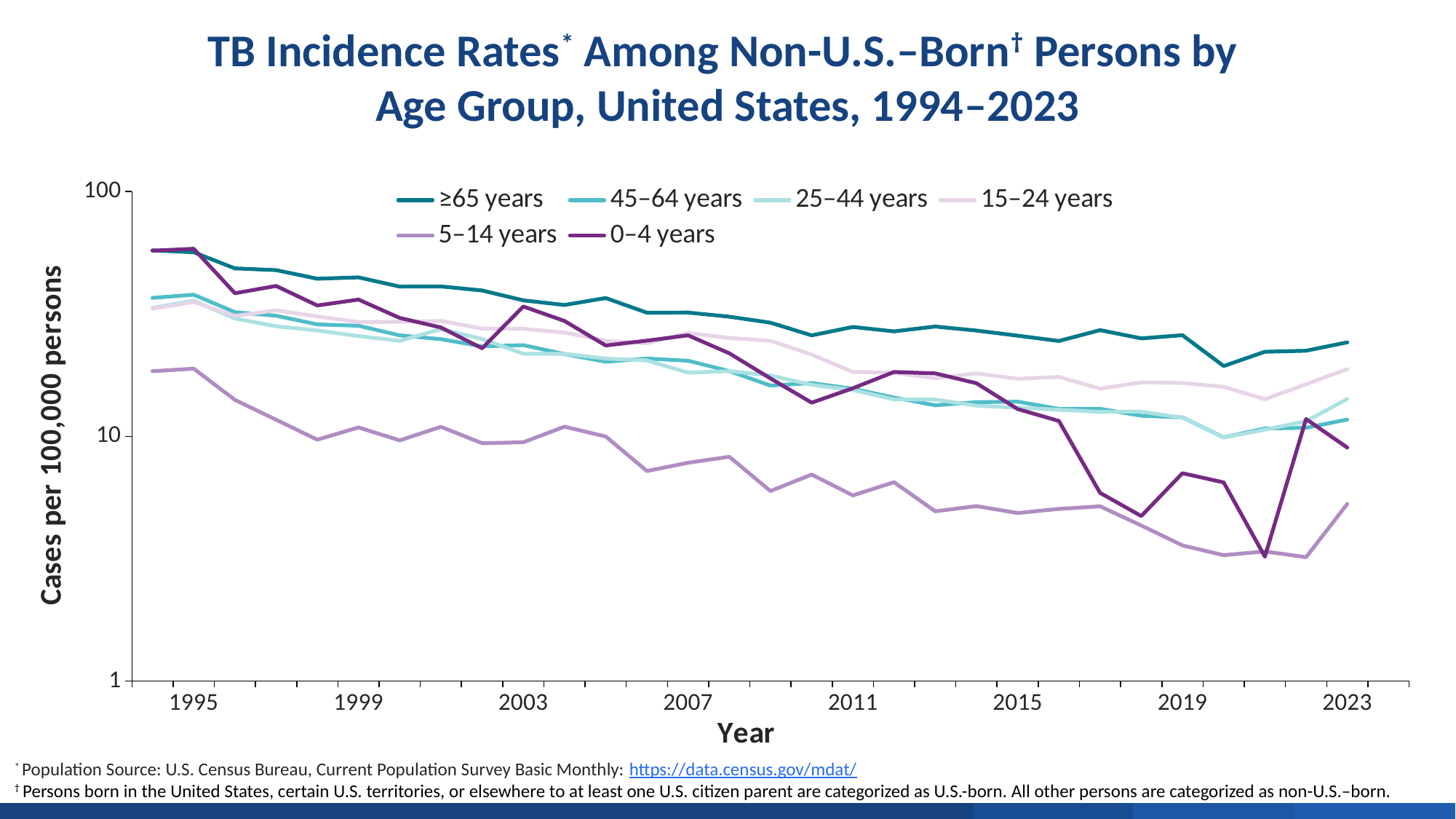
Is the value for 5–14 years in 2020 greater or less than 10? less Is the value for 0–4 years in 1995 greater or less than 10? greater Is the value for ≥65 years in 2023 greater or less than 10? greater Which age group has the lowest TB incidence rate in 2023? 5–14 years In 2019, which is larger: the rate for 0–4 years or the rate for 5–14 years? 0–4 years What is the title of the chart? TB Incidence Rates Among Non-U.S.–Born Persons by Age Group, United States, 1994–2023 Which age group has the highest TB incidence rate in 2023? ≥65 years What is the label of the y axis? Cases per 100,000 persons Which age group has the highest TB incidence rate in 2011? ≥65 years What kind of chart is shown on the slide? Line chart How many series does the legend list? 6 Does the TB incidence rate for ≥65 years generally rise or fall from 1994 to 2023? Fall